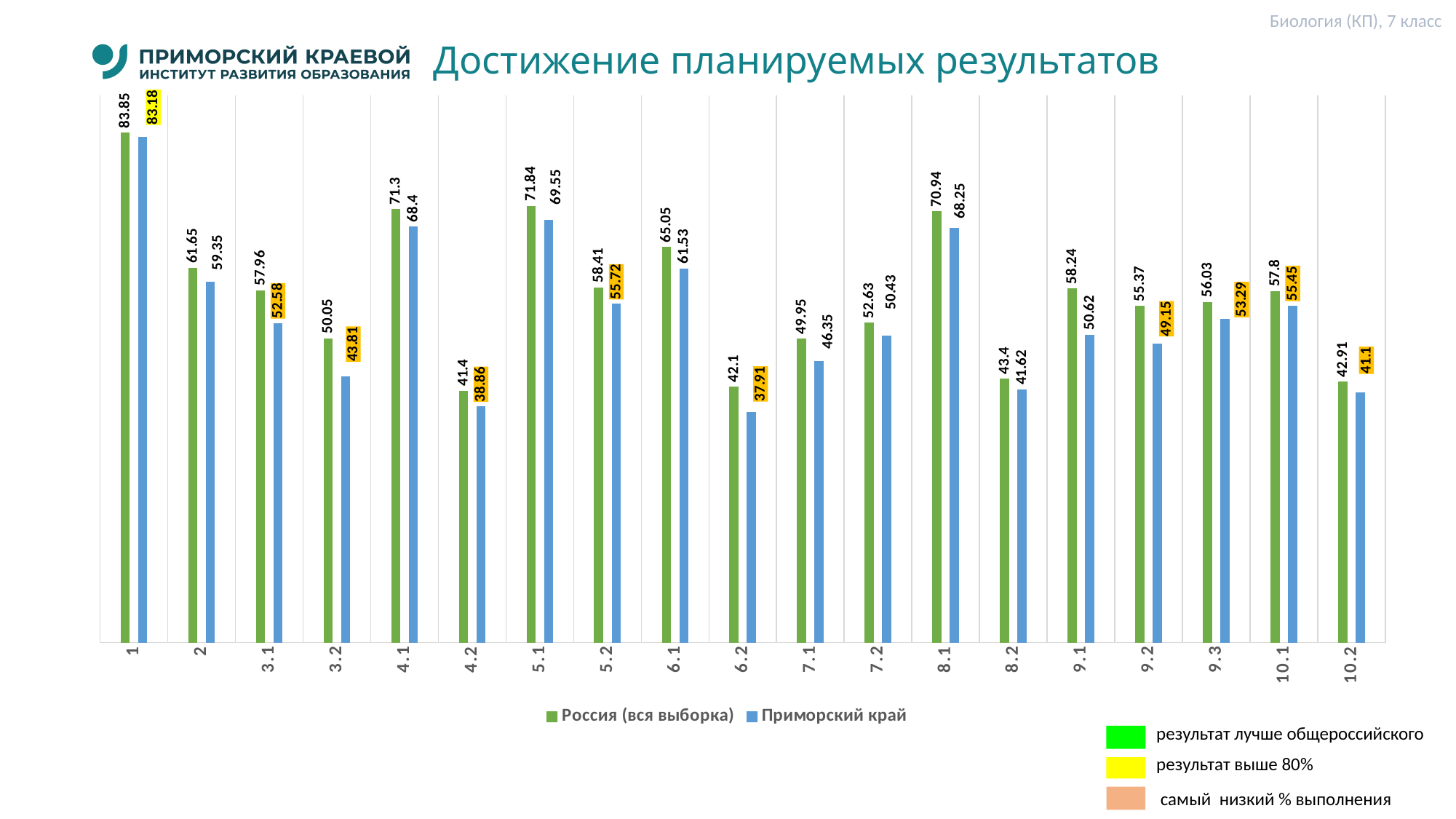
What kind of chart is shown on the slide? bar chart Which task has the lowest value for Россия (вся выборка)? 4.2 What is the value for Приморский край for task 3.2? 43.81 Which task has the lowest value for Приморский край? 6.2 What is the difference between Россия (вся выборка) and Приморский край for task 1? 0.67 Which task has the highest value for Приморский край? 1 How many tasks (categories) are shown on the x axis? 19 Which is larger for Приморский край: task 6.1 or task 7.1? 6.1 What is the value for Приморский край for task 9.2? 49.15 What is the difference between Россия (вся выборка) and Приморский край for task 9.1? 7.62 What is the value for Россия (вся выборка) for task 8.1? 70.94 How many series does the chart legend list? 2